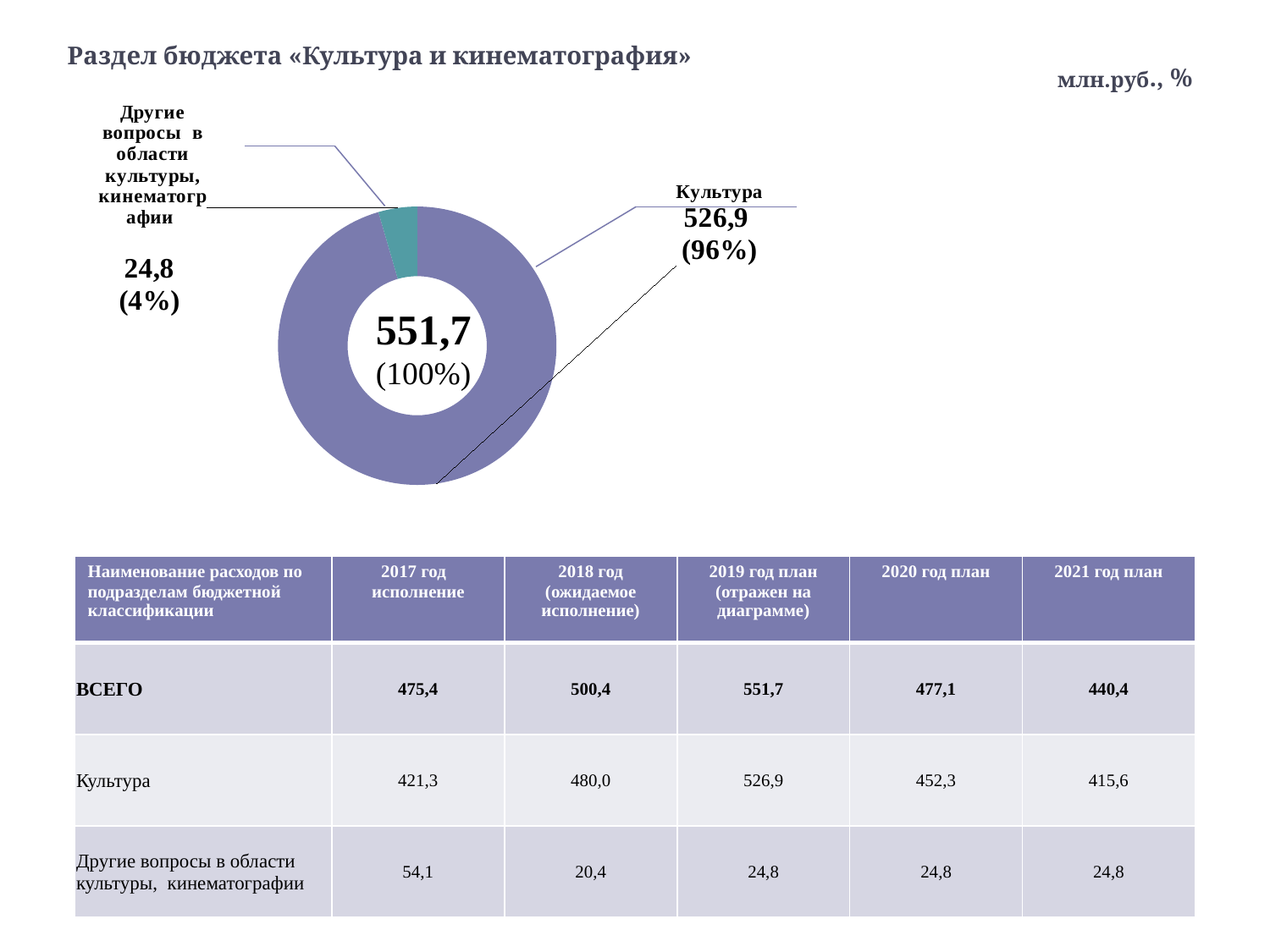
What total value is shown in the centre of the doughnut chart? 551,7 What is the value shown for the "Другие вопросы в области культуры, кинематографии" slice? 24,8 Which is larger on the chart: "Культура" or "Другие вопросы в области культуры, кинематографии"? Культура What is the value shown for the "Культура" slice? 526,9 Which slice of the doughnut chart is the largest? Культура What share of the doughnut does the "Культура" slice represent? 96% What is the difference between the "Культура" value and the "Другие вопросы в области культуры, кинематографии" value on the chart? 502,1 How many slices does the doughnut chart have? 2 What kind of chart is shown on the slide? Doughnut (pie) chart What share of the doughnut does the "Другие вопросы в области культуры, кинематографии" slice represent? 4% What units are indicated for the chart in the top right of the slide? млн.руб., % Which slice of the doughnut chart is the smallest? Другие вопросы в области культуры, кинематографии